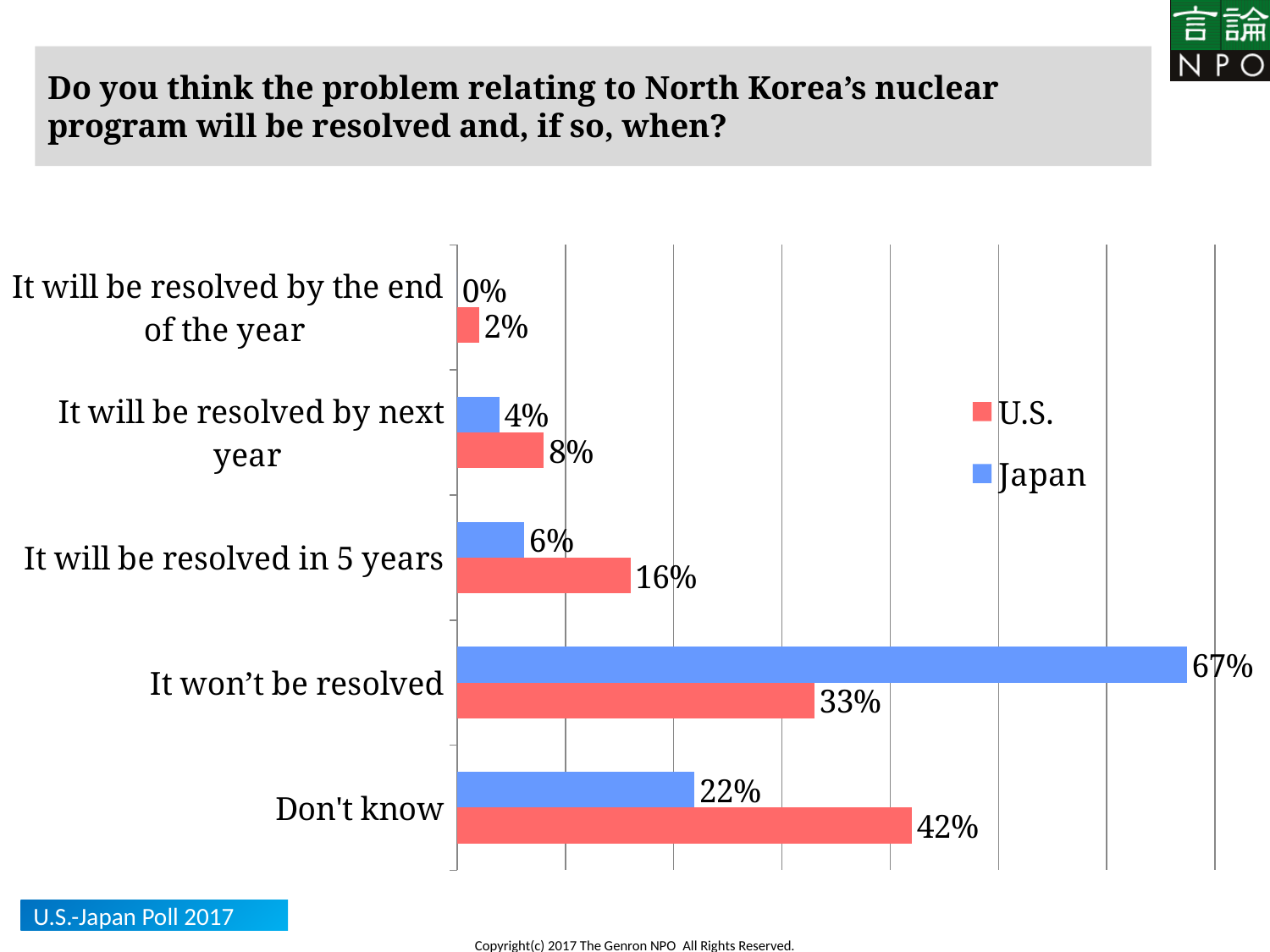
What kind of chart is shown on the slide? Bar chart Which response category has the lowest value for the U.S.? It will be resolved by the end of the year What percentage of U.S. respondents answered "Don't know"? 42% What is the difference between the Japan and U.S. values for "It won't be resolved"? 34 percentage points What percentage of Japan respondents said the problem won't be resolved? 67% How many series does the legend list? 2 What is the Japan value for "It will be resolved by the end of the year"? 0% For "Don't know", which is larger, the U.S. value or the Japan value? U.S. Which colour represents Japan in the chart? Blue Which response category has the highest value for Japan? It won't be resolved What is the U.S. value for "It will be resolved in 5 years"? 16% How many response categories are shown on the chart? 5